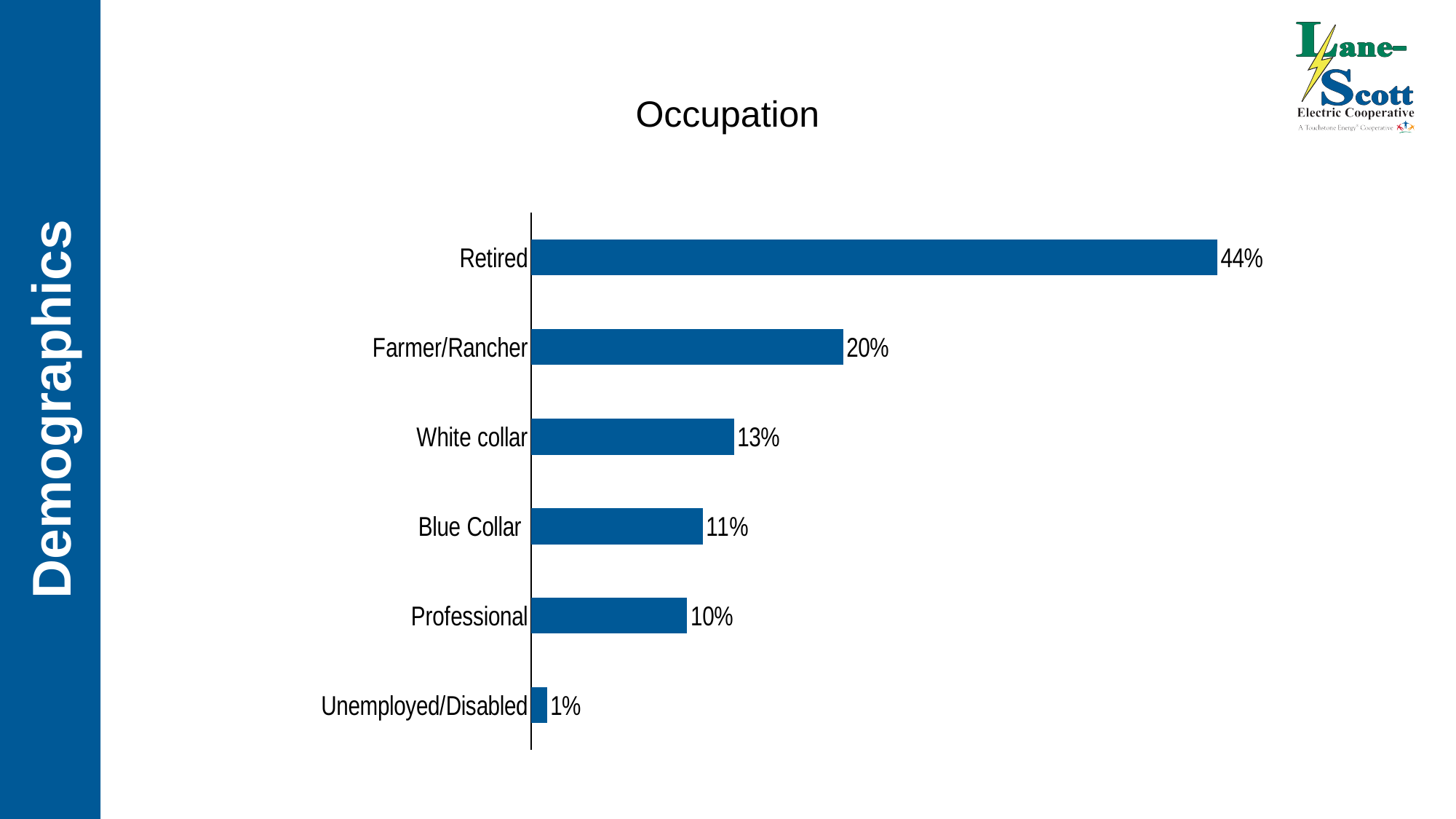
What percentage is shown for White collar? 13% What kind of chart is shown on the slide? Bar chart What is the value for Unemployed/Disabled? 1% Which occupation category has the highest value? Retired What is the title of the chart? Occupation What percentage of respondents are Retired? 44% How many occupation categories are shown in the chart? 6 Which occupation category has the lowest value? Unemployed/Disabled What is the value shown for Farmer/Rancher? 20% Which is larger, the value for White collar or the value for Professional? White collar What is the difference between the Blue Collar and Professional values? 1% What is the difference between the Retired and Farmer/Rancher values? 24%